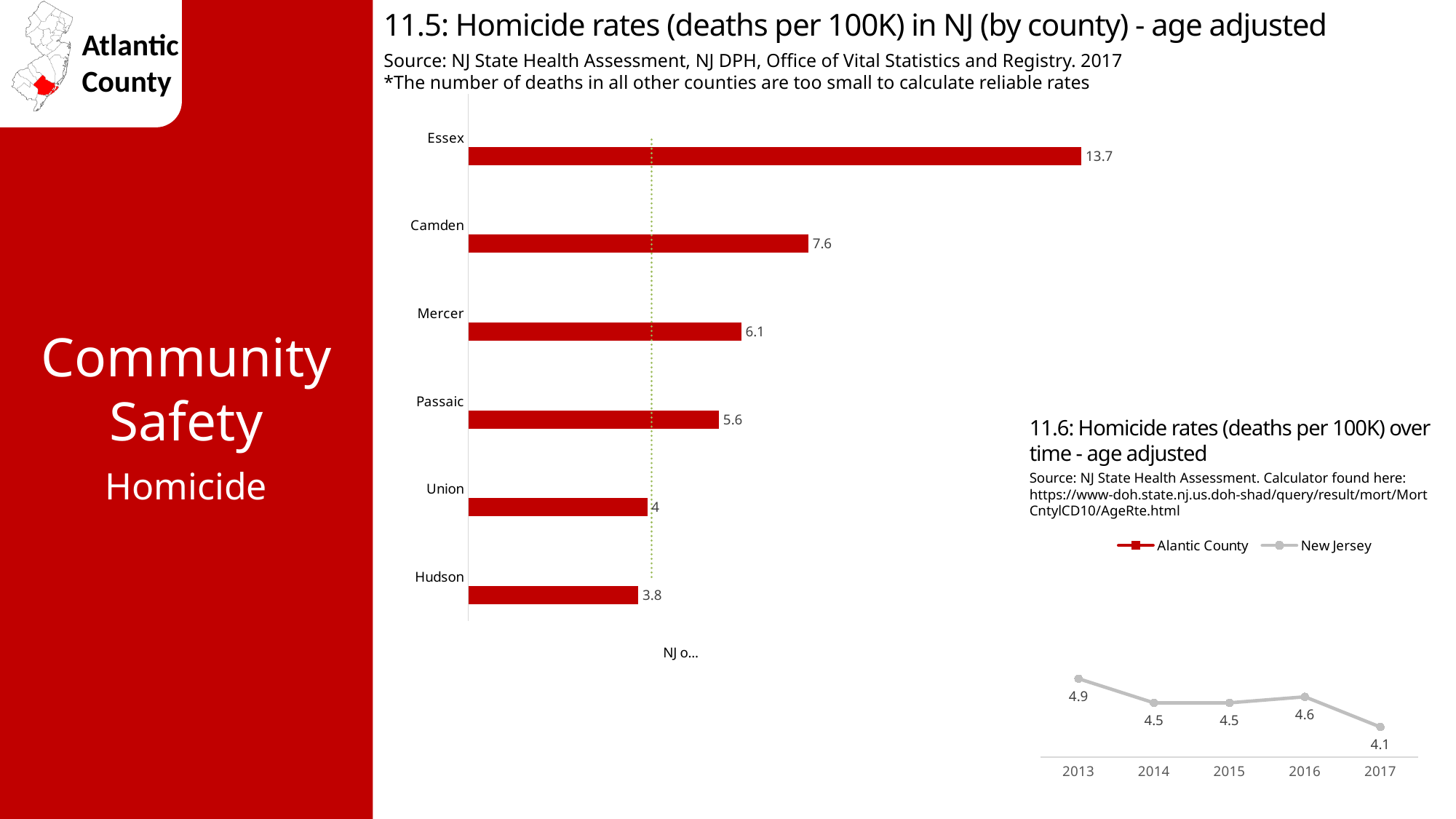
In chart 11.5, which county has the highest homicide rate? Essex In chart 11.5, what is the difference between the homicide rates of Essex and Camden? 6.1 In chart 11.6, what is the New Jersey homicide rate in 2013? 4.9 In chart 11.6, how many series does the legend list? 2 In chart 11.5, which county has a higher homicide rate, Mercer or Passaic? Mercer In chart 11.6, what is the New Jersey homicide rate in 2017? 4.1 In chart 11.5, which county has the lowest homicide rate? Hudson In chart 11.5, what is the homicide rate for Camden? 7.6 In chart 11.5, how many counties are shown? 6 What kind of chart is chart 11.5? Bar chart In chart 11.6, does the New Jersey homicide rate rise or fall from 2016 to 2017? Fall In chart 11.5, what is the homicide rate for Essex? 13.7